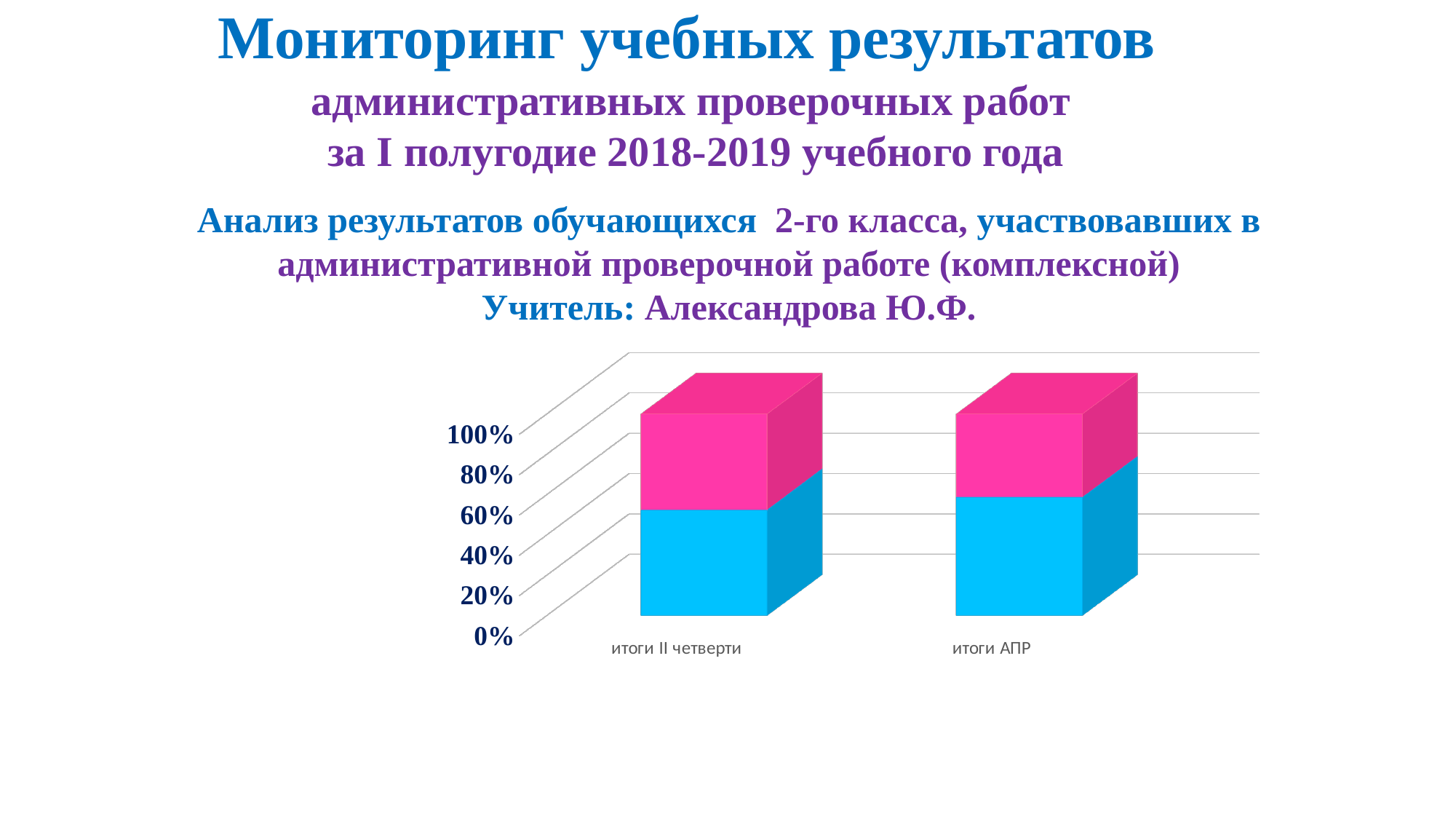
How many categories are shown on the x axis of the chart? 2 Is the blue segment for "итоги II четверти" greater or less than 80%? less Is the blue segment for "итоги II четверти" greater or less than 40%? greater What is the label of the first category on the x axis? итоги II четверти What is the label of the second category on the x axis? итоги АПР What kind of chart is shown on the slide? stacked bar chart Is the blue segment for "итоги АПР" greater or less than 80%? less Which category has the larger pink segment, "итоги II четверти" or "итоги АПР"? итоги II четверти What is the highest value labelled on the vertical axis of the chart? 100% Which category has the larger blue segment, "итоги II четверти" or "итоги АПР"? итоги АПР Does the blue segment rise or fall from "итоги II четверти" to "итоги АПР"? rise